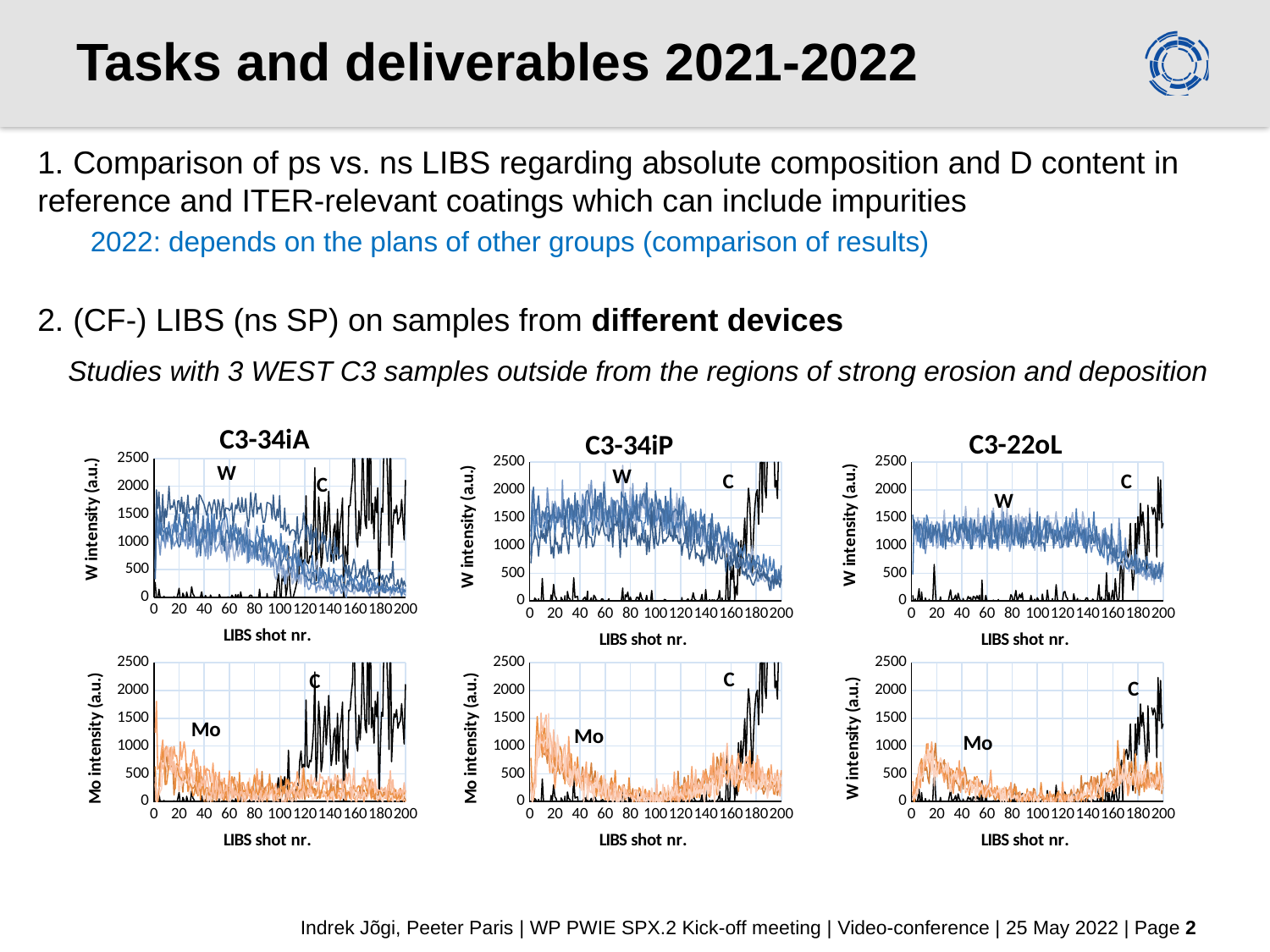
In the bottom chart under C3-34iP, does the C intensity rise or fall along the x axis? rise In the top chart titled C3-34iP, is the W intensity at LIBS shot 40 greater or less than 1000? greater What kind of chart is the top chart titled C3-34iA? line chart In the bottom chart under C3-34iA, is the Mo intensity at LIBS shot 100 greater or less than 1000? less In the top chart titled C3-22oL, is the W intensity at LIBS shot 100 greater or less than 1000? greater In the top chart titled C3-34iA, at LIBS shot 20, which is higher, the W intensity or the C intensity? W How many charts are shown on the slide? 6 What is the highest value shown on the y axis of the top chart titled C3-34iA? 2500 What is the x-axis label of the charts on the slide? LIBS shot nr. In the top chart titled C3-22oL, does the W intensity rise or fall as the LIBS shot number increases? fall In the top chart titled C3-34iP, does the C intensity rise or fall as the LIBS shot number increases? rise What is the y-axis label of the bottom-left chart (under C3-34iA)? Mo intensity (a.u.)